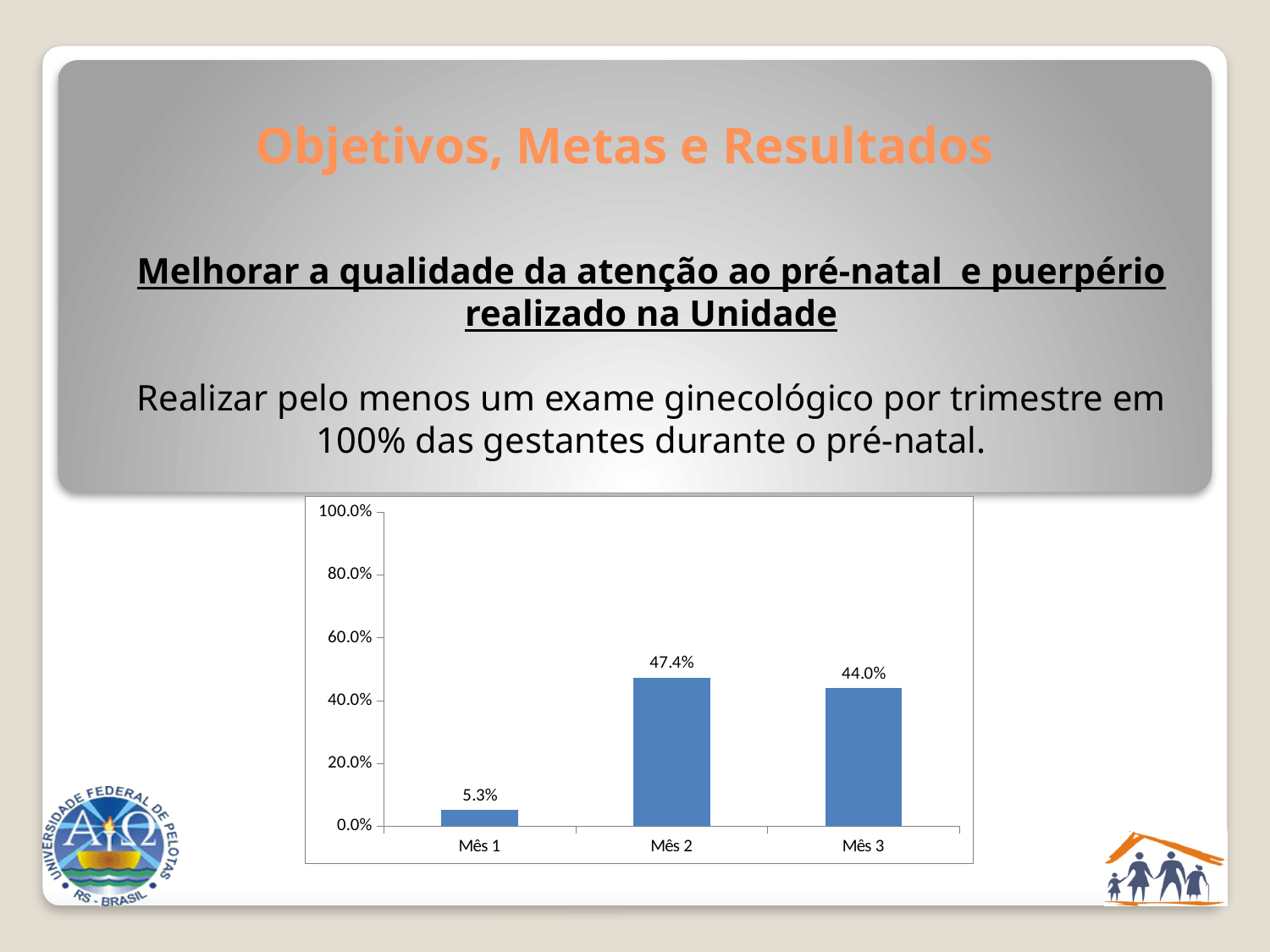
How many categories are shown on the x axis? 3 Which month has the lowest value? Mês 1 What is the difference between the values for Mês 2 and Mês 1? 42.1% What is the highest value shown on the y axis? 100.0% Which is larger, the value for Mês 1 or the value for Mês 3? Mês 3 Is the value for Mês 2 greater or less than 40.0%? greater What is the value for Mês 3? 44.0% Which month has the highest value? Mês 2 What is the value for Mês 2? 47.4% What kind of chart is shown on the slide? bar chart What is the value for Mês 1? 5.3% What is the difference between the values for Mês 2 and Mês 3? 3.4%